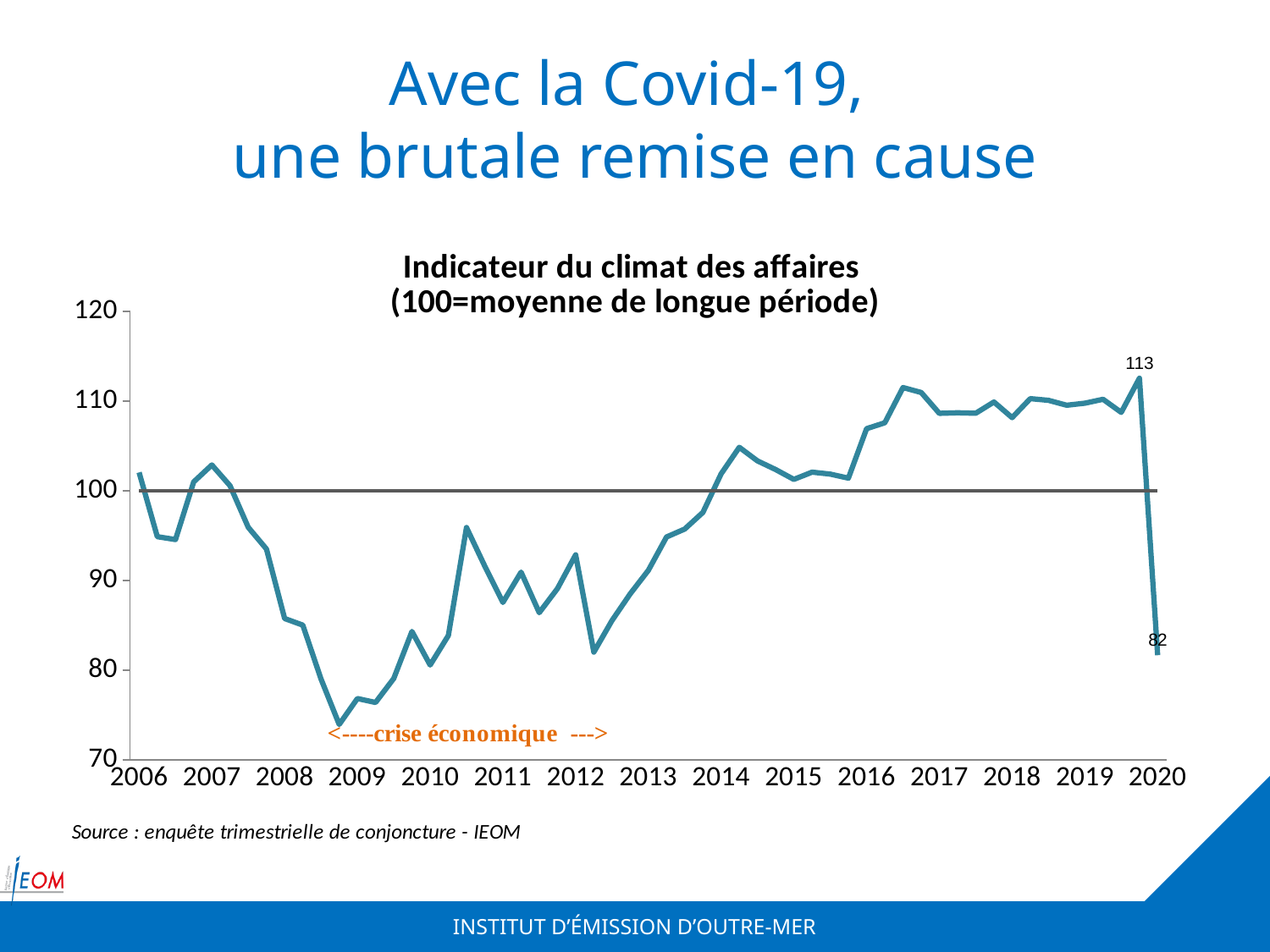
How many years are labelled on the x axis? 15 Does the indicator rise or fall between 2014 and 2016? rise What is the last labelled value of the indicator in 2020? 82 What is the labelled peak value reached just before the drop in 2020? 113 What kind of chart is shown on the slide? line chart Is the value of the indicator in 2017 greater or less than 100? greater What is the title of the chart? Indicateur du climat des affaires (100=moyenne de longue période) Is the lowest value of the indicator in 2009 greater or less than 80? less Is the indicator higher in 2009 or in 2017? 2017 At what value is the horizontal reference line drawn on the chart? 100 By how many points did the indicator fall from the labelled peak of 113 to the labelled value of 82? 31